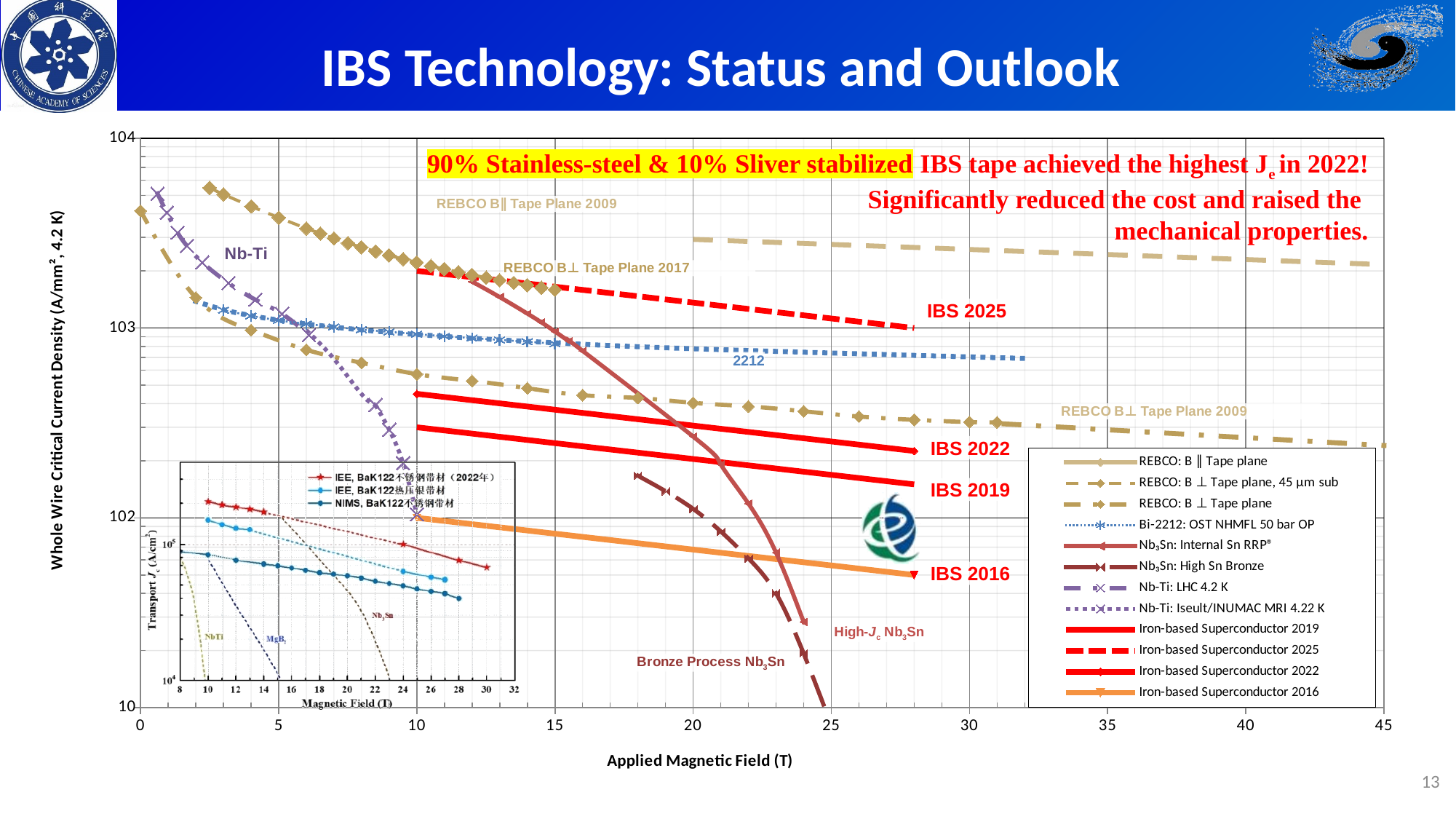
Among the iron-based superconductor (IBS) curves, which one lies highest on the main chart? IBS 2025 What is the y-axis title of the main chart? Whole Wire Critical Current Density (A/mm², 4.2 K) How many series does the legend of the main chart list? 12 Among the iron-based superconductor (IBS) curves, which one lies lowest on the main chart? IBS 2016 On the main chart, is the value of the IBS 2025 curve at 10 T greater or less than 10^3? greater At 28 T on the main chart, which is larger: the IBS 2022 curve or the IBS 2019 curve? IBS 2022 On the main chart, does the IBS 2022 curve rise or fall as the applied magnetic field increases? fall What is the x-axis title of the main chart? Applied Magnetic Field (T) On the main chart, is the value of the IBS 2022 curve at 28 T greater or less than 10^3? less Which series is highest on the main chart at 45 T? REBCO: B ⊥ Tape plane, 45 μm sub What kind of chart is the main chart on the slide? line chart On the main chart, is the value of the Bi-2212 curve at 30 T greater or less than 10^3? less